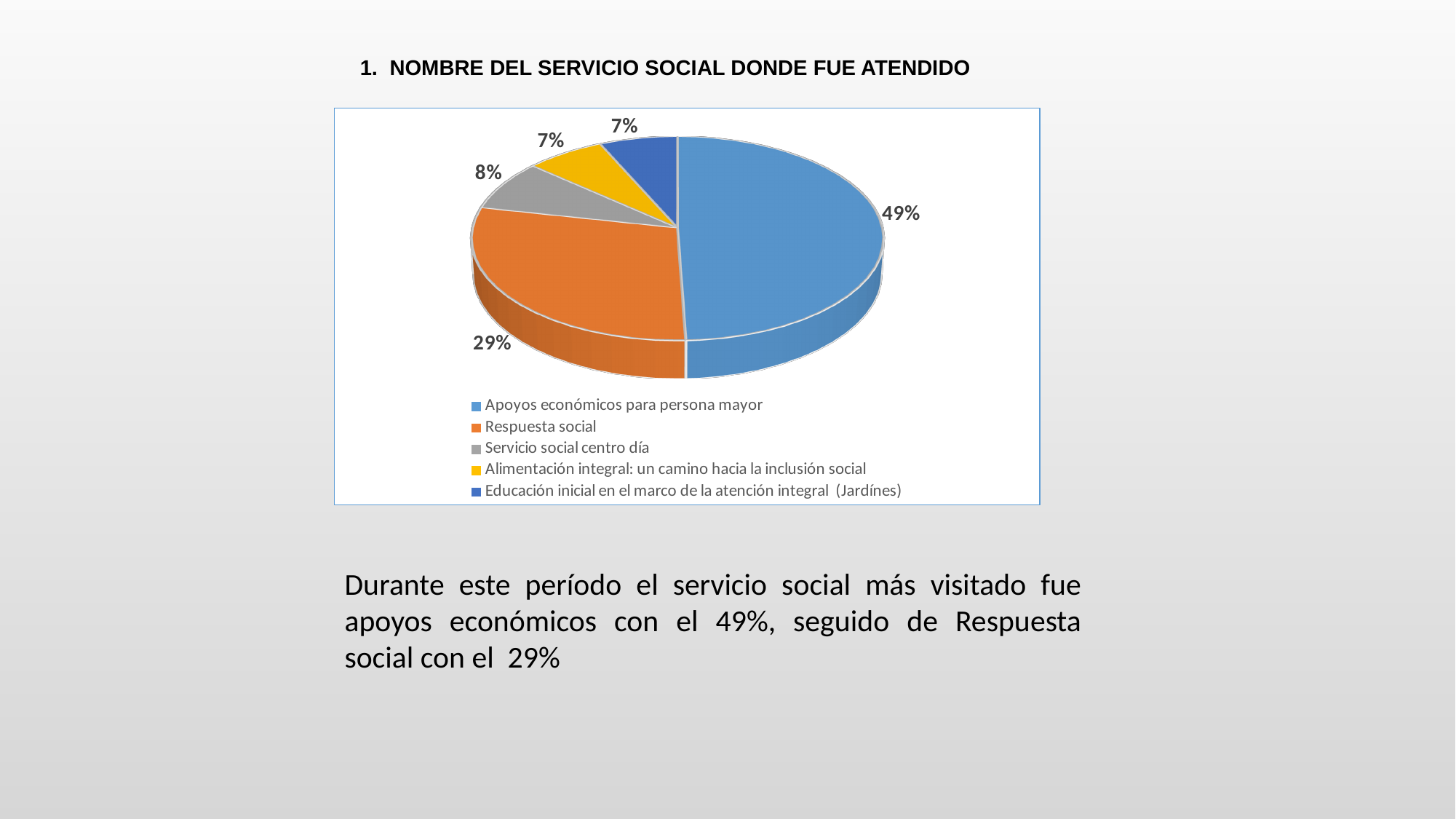
What share of the pie does Apoyos económicos para persona mayor represent? 49% What is the difference in percentage points between Apoyos económicos para persona mayor and Respuesta social? 20 What colour is the slice for Respuesta social? Orange Which category has the largest slice of the pie? Apoyos económicos para persona mayor Which is larger, the slice for Respuesta social or the slice for Servicio social centro día? Respuesta social What type of chart is shown on the slide? Pie chart What share of the pie does Alimentación integral: un camino hacia la inclusión social represent? 7% What share of the pie does Educación inicial en el marco de la atención integral (Jardínes) represent? 7% What is the combined share of Apoyos económicos para persona mayor and Respuesta social? 78% How many categories are shown in the pie chart? 5